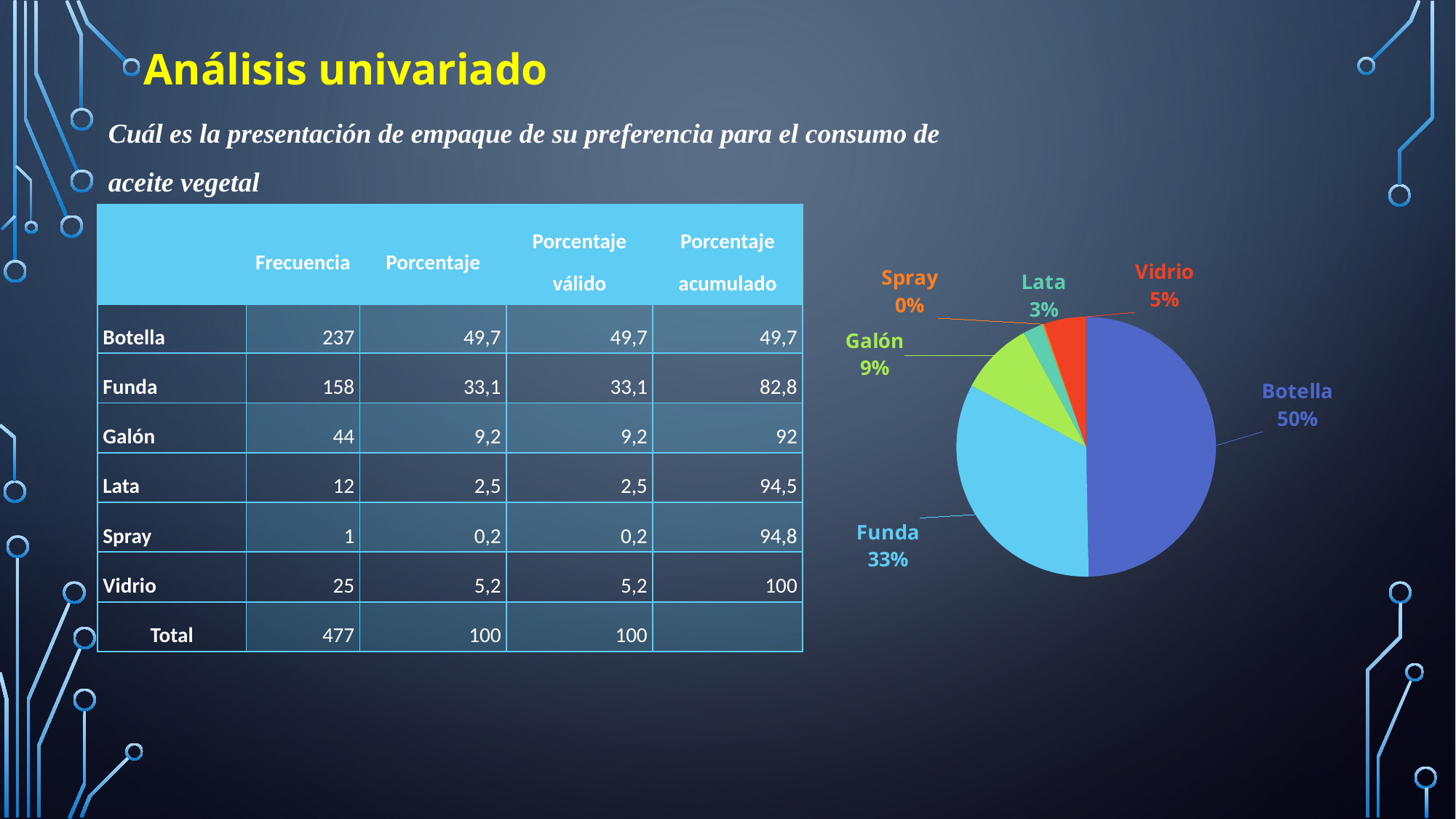
What percentage does the Lata slice show in the pie chart? 3% What kind of chart is shown on the slide? pie chart What percentage does the Spray slice show in the pie chart? 0% What is the difference in percentage points between the Botella and Funda slices in the pie chart? 17 What percentage does the Botella slice show in the pie chart? 50% What percentage does the Galón slice show in the pie chart? 9% Which category has the largest slice in the pie chart? Botella How many slices does the pie chart have? 6 What percentage does the Funda slice show in the pie chart? 33% What percentage does the Vidrio slice show in the pie chart? 5% Which category has the smallest slice in the pie chart? Spray In the pie chart, which is larger, Galón or Vidrio? Galón